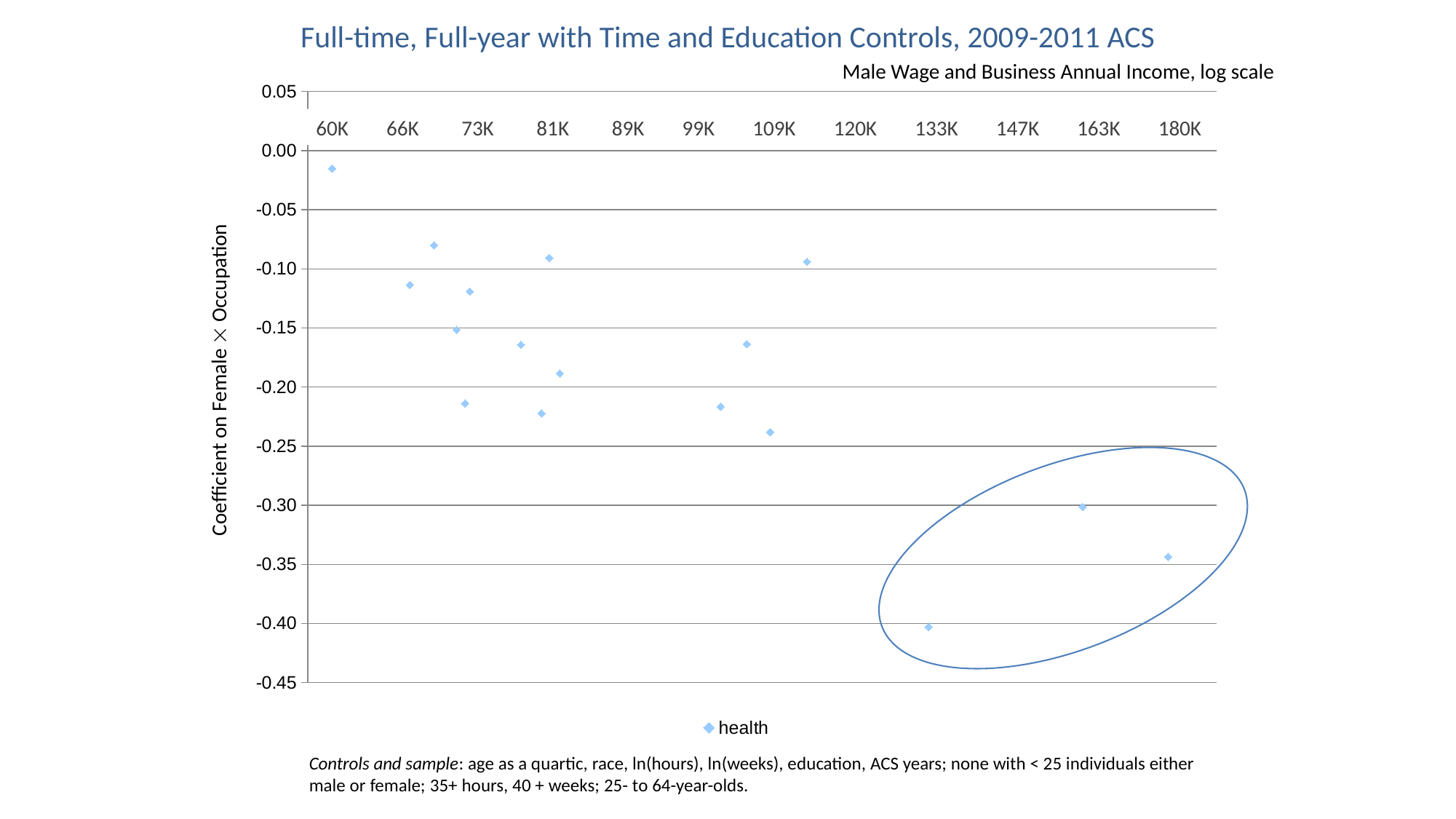
How many data points are enclosed by the drawn ellipse? 3 What is the name of the series shown in the legend? health Is the coefficient for the point plotted near 180K greater or less than -0.30? less Is the coefficient for the point plotted near 180K greater or less than -0.40? greater What is the title of the chart? Full-time, Full-year with Time and Education Controls, 2009-2011 ACS How many data points are plotted in the chart? 17 What kind of chart is shown on the slide? Scatter chart Near which x-axis value is the point with the highest coefficient plotted? 60K How many series does the legend list? 1 Is the coefficient for the point plotted at 60K greater or less than -0.05? greater Which point has the lowest coefficient: the one plotted near 133K or the one plotted near 180K? The one near 133K Do the plotted coefficient values generally rise or fall as male wage and business annual income increases along the x axis? Fall